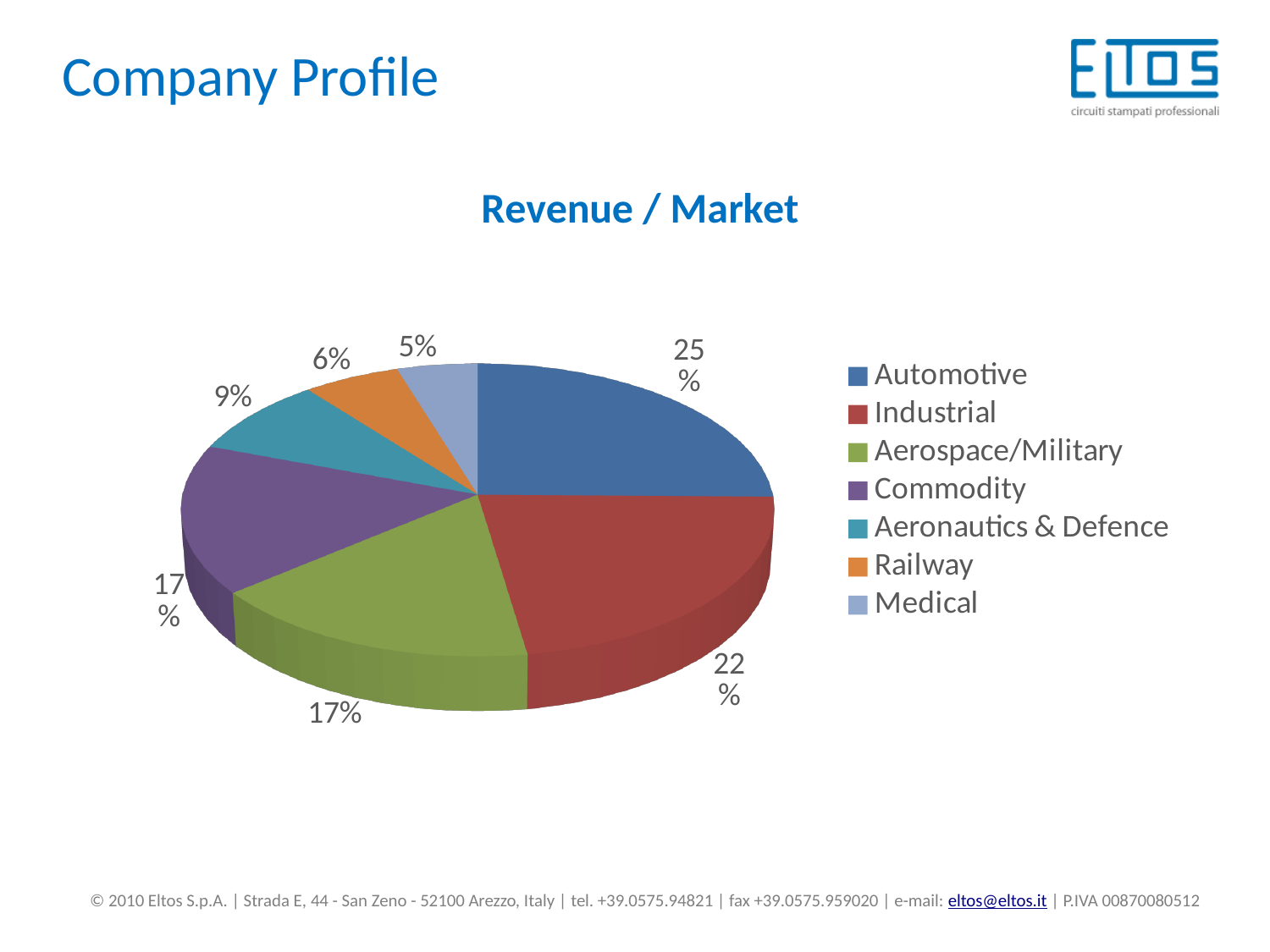
What share of revenue does the Medical market account for? 5% What share of revenue does the Automotive market account for? 25% What kind of chart is shown on the slide? Pie chart Which market has the smallest share of revenue? Medical What is the difference in percentage points between the Automotive and Industrial shares? 3 What share of revenue does the Aeronautics & Defence market account for? 9% What is the title of the chart? Revenue / Market Which market has the largest share of revenue? Automotive Which has a larger share of revenue, Railway or Aeronautics & Defence? Aeronautics & Defence How many markets are shown in the pie chart? 7